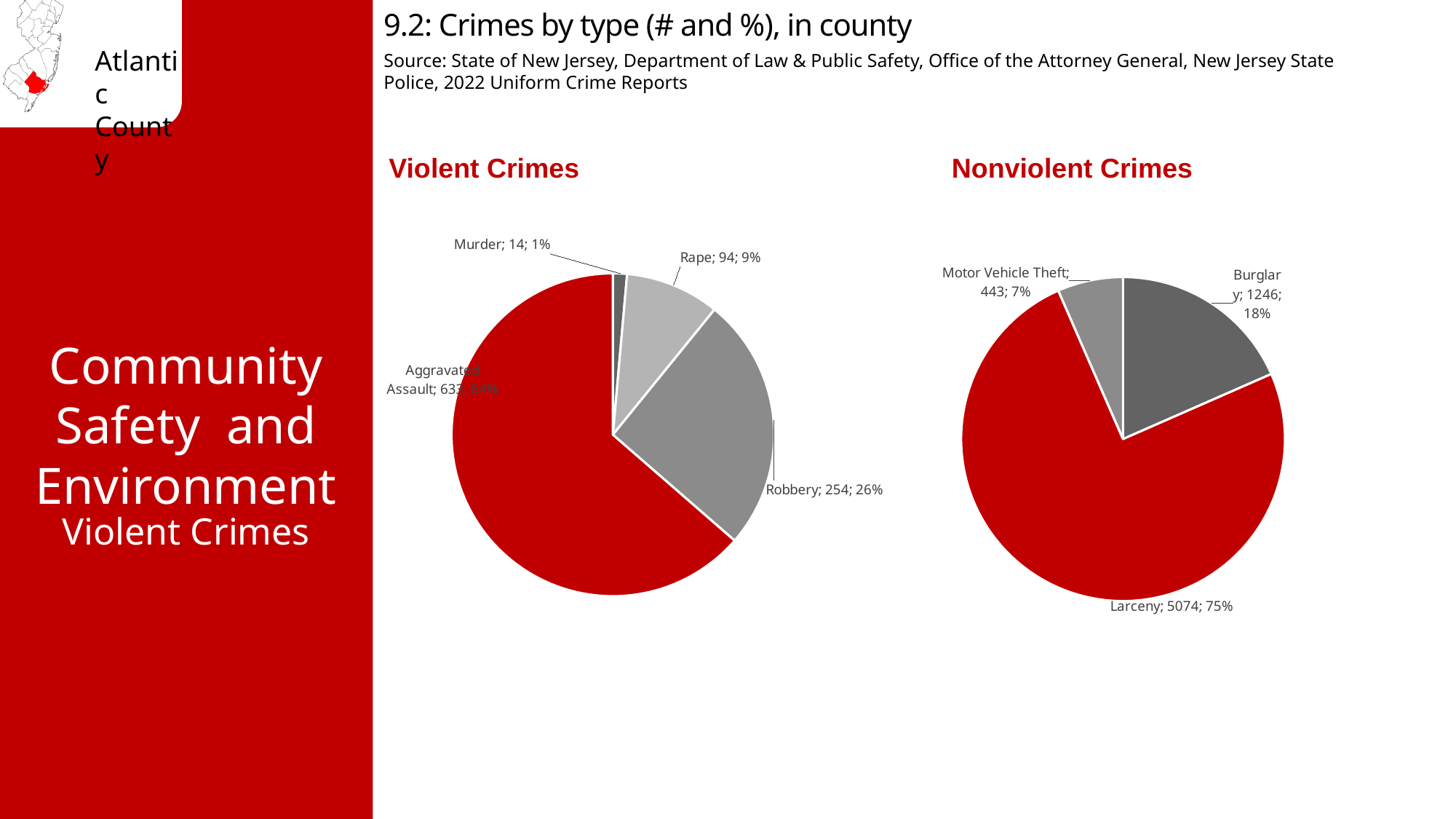
How many categories are shown in the Nonviolent Crimes chart? 3 In the Nonviolent Crimes chart, what is the difference between the number of burglaries and motor vehicle thefts? 803 In the Violent Crimes chart, which crime type has the largest slice? Aggravated Assault In the Nonviolent Crimes chart, how many larcenies are shown? 5074 In the Violent Crimes chart, how many murders are shown? 14 In the Violent Crimes chart, what is the difference between the number of robberies and the number of rapes? 160 In the Nonviolent Crimes chart, what share of nonviolent crimes is burglary? 18% What type of chart is used for the Violent Crimes chart? pie chart In the Nonviolent Crimes chart, which is larger, burglary or motor vehicle theft? Burglary In the Violent Crimes chart, how many rapes are shown? 94 In the Violent Crimes chart, what share of violent crimes is robbery? 26% In the Violent Crimes chart, which crime type has the smallest slice? Murder